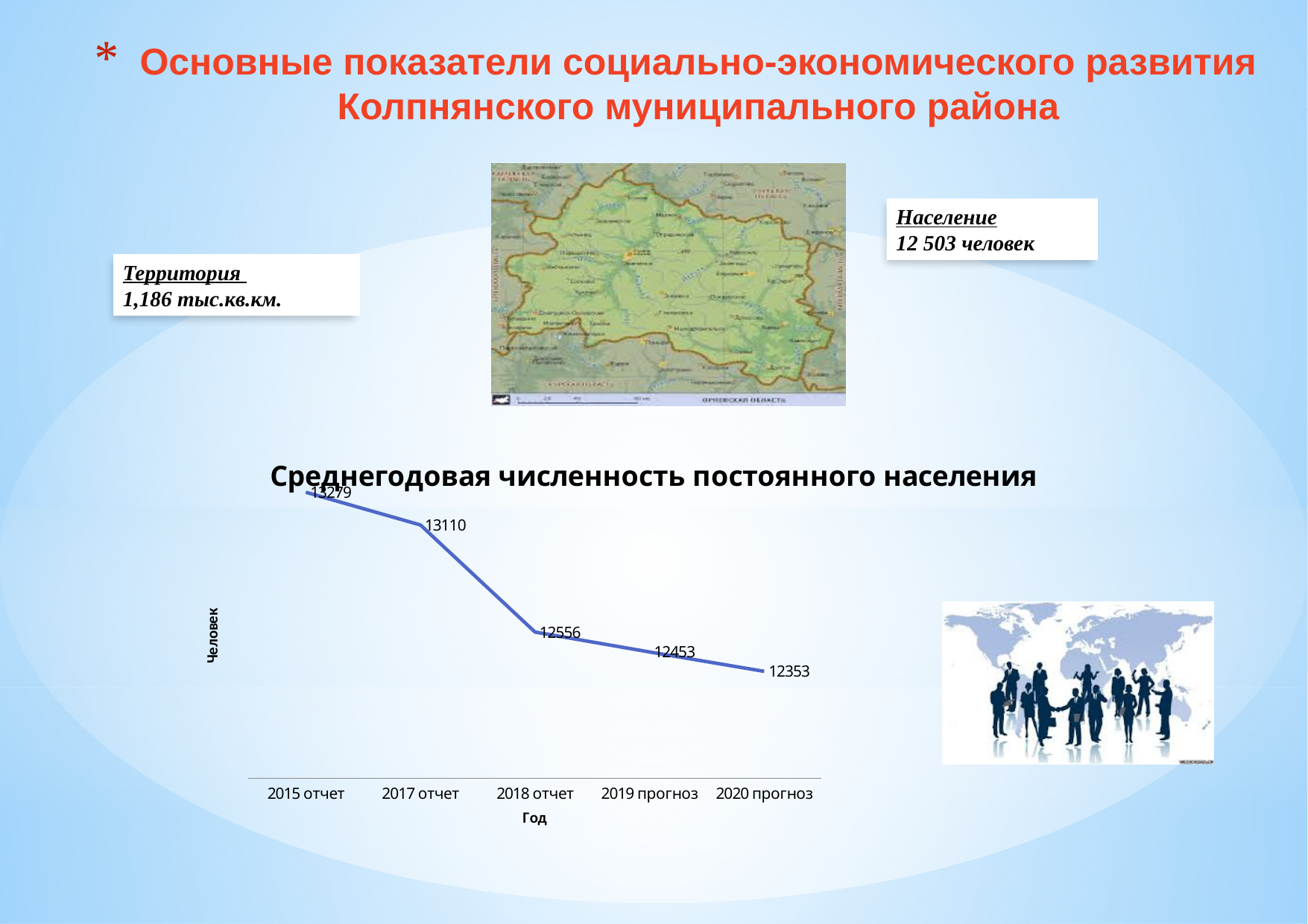
What is the value for 2018 отчет? 12556 What is the value for 2017 отчет? 13110 What is the value for 2015 отчет? 13279 What is the value for 2020 прогноз? 12353 How many data points are plotted on the chart? 5 Which year has the highest value on the chart? 2015 отчет Which is larger, the value for 2017 отчет or the value for 2018 отчет? 2017 отчет What type of chart is used to show the average annual permanent population? line chart Which year has the lowest value on the chart? 2020 прогноз Do the values rise or fall along the x axis? fall What is the difference between the values for 2015 отчет and 2020 прогноз? 926 What is the value for 2019 прогноз? 12453